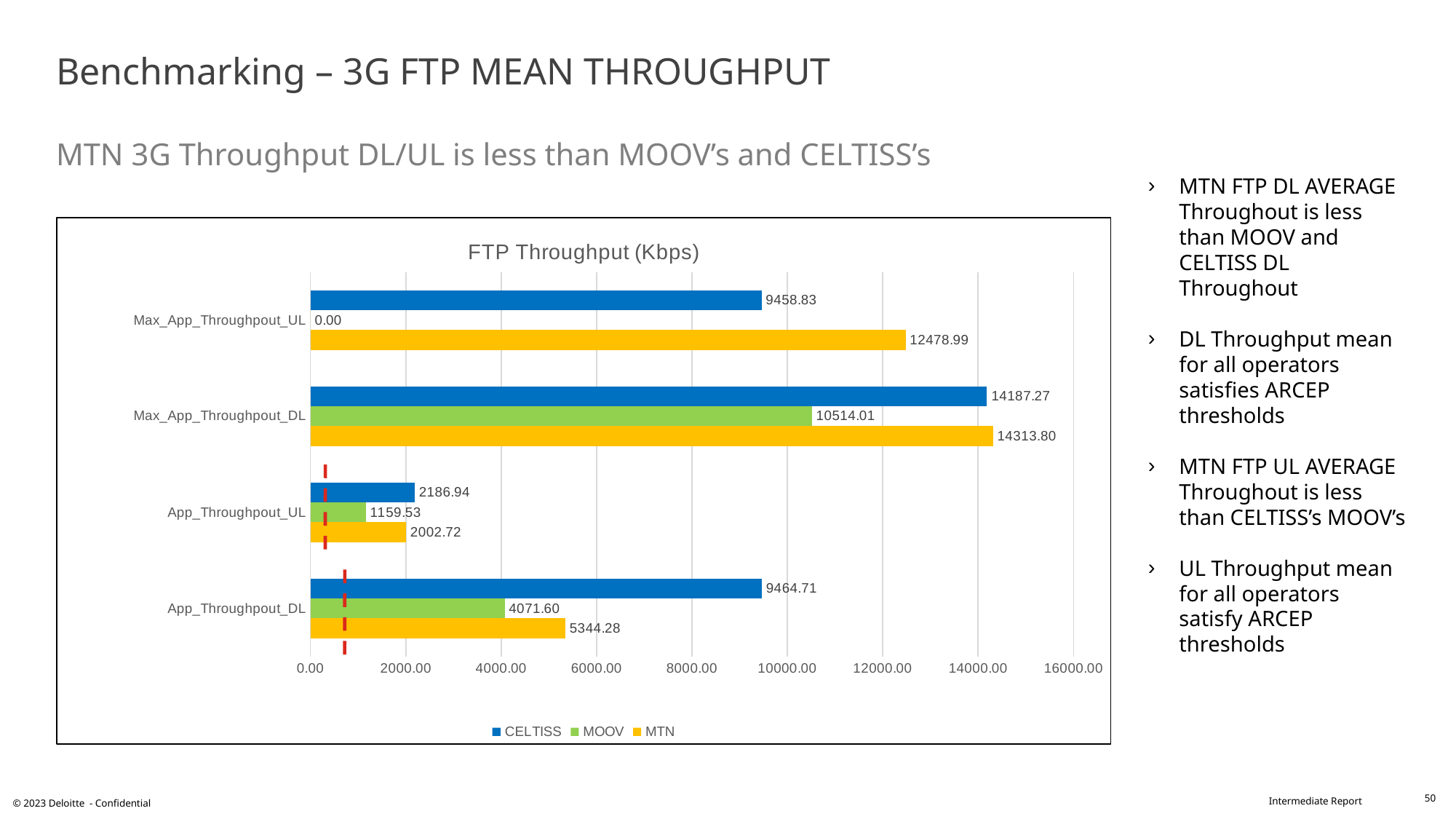
How many series does the legend of the FTP Throughput (Kbps) chart list? 3 Is the MOOV value for Max_App_Throughpout_DL greater or less than 10000.00 in the FTP Throughput (Kbps) chart? greater In the FTP Throughput (Kbps) chart, is the MTN value for Max_App_Throughpout_UL larger or smaller than the CELTISS value for the same category? larger What is the CELTISS value for App_Throughpout_UL in the FTP Throughput (Kbps) chart? 2186.94 Which operator has the lowest value for App_Throughpout_UL in the FTP Throughput (Kbps) chart? MOOV How many categories are shown on the vertical axis of the FTP Throughput (Kbps) chart? 4 What is the MOOV value for App_Throughpout_DL in the FTP Throughput (Kbps) chart? 4071.60 Which operator has the highest value for App_Throughpout_DL in the FTP Throughput (Kbps) chart? CELTISS What type of chart is the FTP Throughput (Kbps) chart? Bar chart What is the MOOV value for Max_App_Throughpout_UL in the FTP Throughput (Kbps) chart? 0.00 What is the difference between the CELTISS and MTN values for App_Throughpout_DL in the FTP Throughput (Kbps) chart? 4120.43 What is the MTN value for Max_App_Throughpout_DL in the FTP Throughput (Kbps) chart? 14313.80